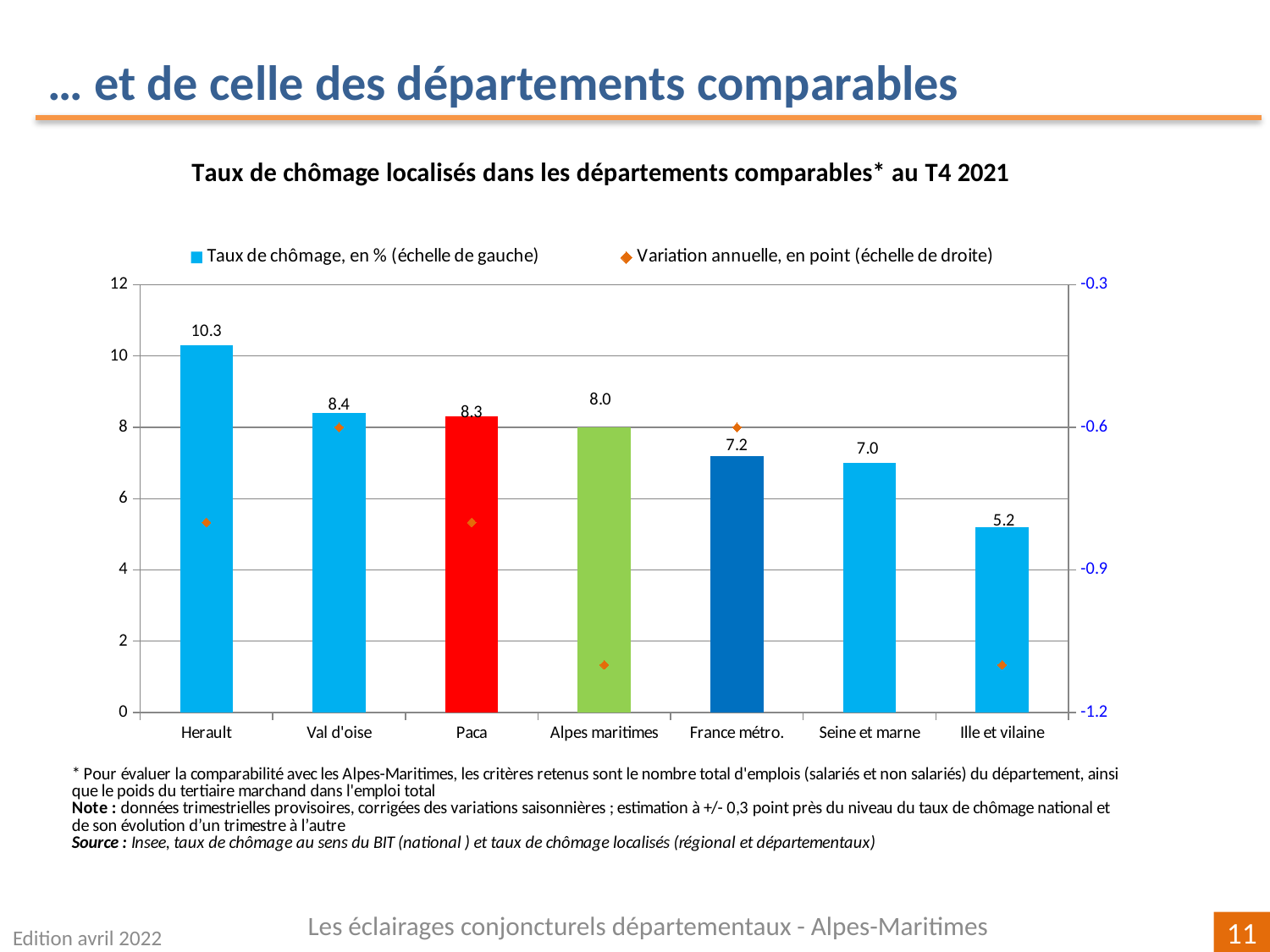
How many categories are shown on the x axis? 7 How many series does the legend list? 2 Which category has the highest unemployment rate? Herault What is the unemployment rate shown for Alpes maritimes? 8.0 What is the unemployment rate (taux de chômage) for Herault? 10.3 What kind of chart is used to show the unemployment rate series? Bar chart What is the unemployment rate shown for France métro.? 7.2 Is the annual variation (variation annuelle) for Alpes maritimes greater or less than -0.9? less Which has a higher unemployment rate, Val d'oise or Seine et marne? Val d'oise What is the difference between the unemployment rates of Herault and Ille et vilaine? 5.1 Which bar is coloured red? Paca Which category has the lowest unemployment rate? Ille et vilaine